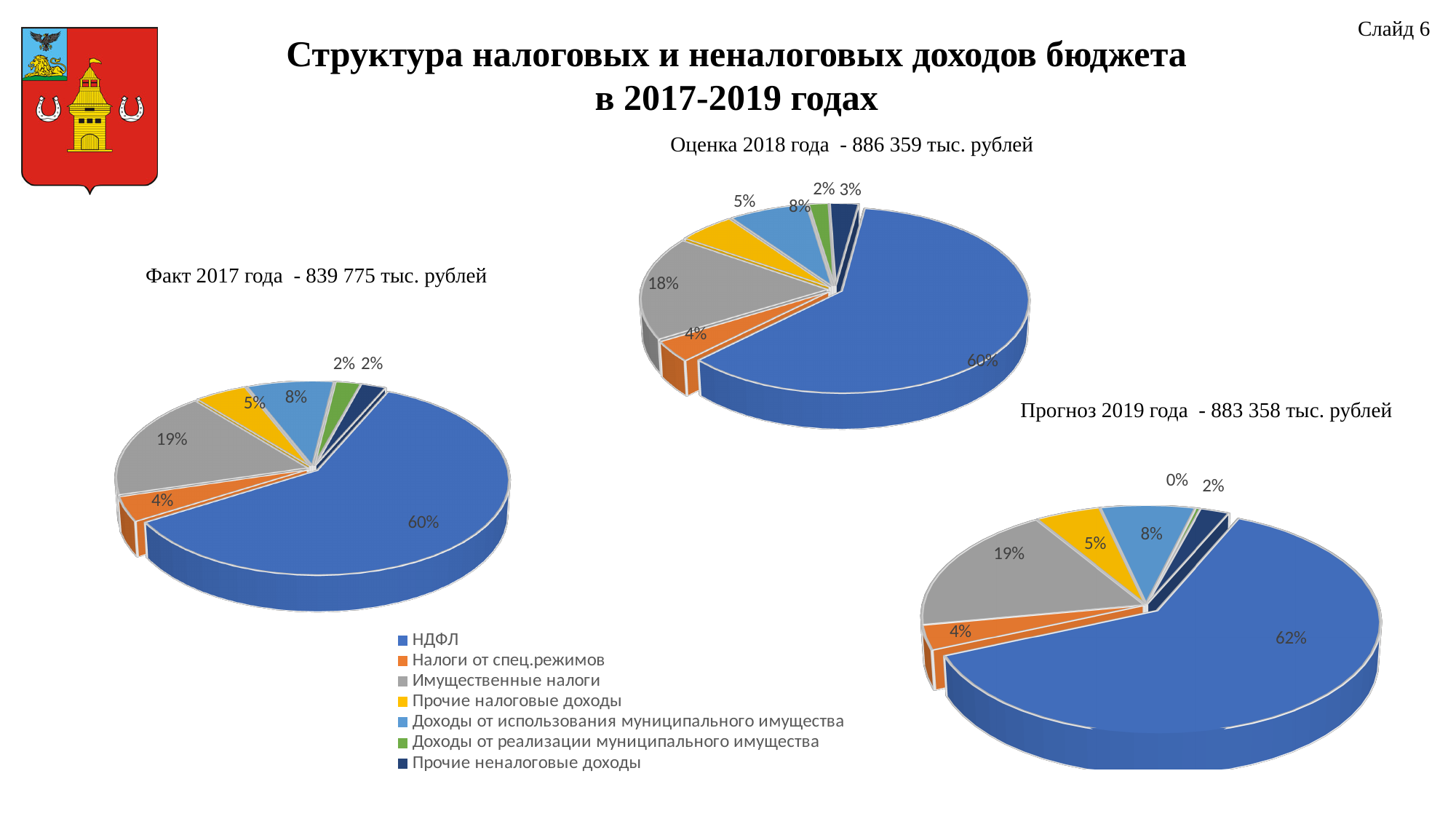
What kind of charts are shown on the slide? Pie charts In the 'Оценка 2018 года' pie chart, what is the difference between the share of НДФЛ and the share of Имущественные налоги? 42% In the 'Прогноз 2019 года' pie chart, what share do Доходы от реализации муниципального имущества have? 0% In the 'Факт 2017 года' pie chart, what share does НДФЛ have? 60% In the 'Оценка 2018 года' pie chart, what share do Имущественные налоги have? 18% What total amount is stated for 'Оценка 2018 года'? 886 359 тыс. рублей How many series does the shared legend list? 7 In the 'Факт 2017 года' pie chart, which is larger: the share of Прочие налоговые доходы or the share of Доходы от использования муниципального имущества? Доходы от использования муниципального имущества What colour represents НДФЛ in the legend? Blue In the 'Прогноз 2019 года' pie chart, which category has the smallest share? Доходы от реализации муниципального имущества In the 'Факт 2017 года' pie chart, which category has the largest share? НДФЛ